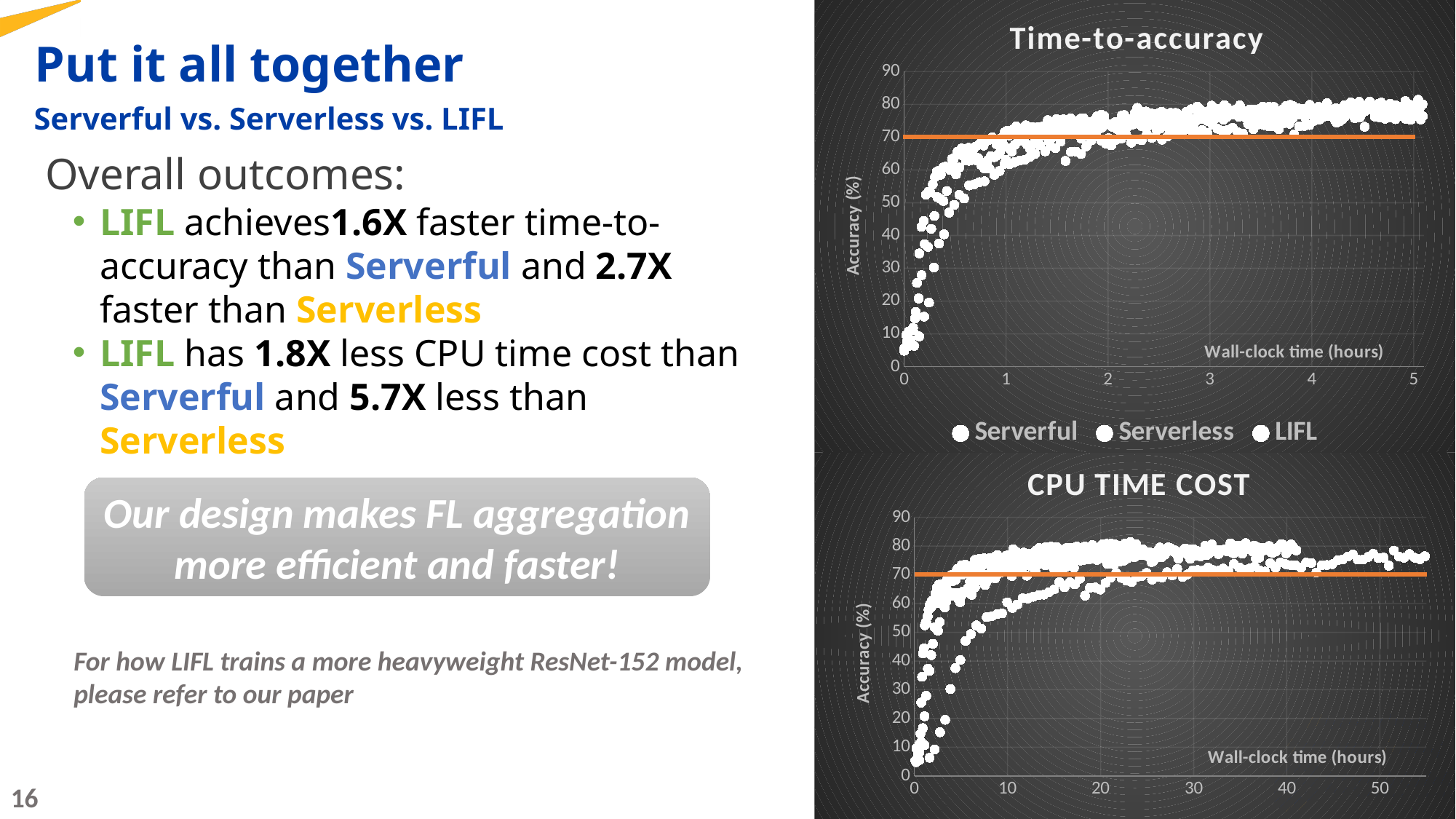
In the "Time-to-accuracy" chart, is the accuracy of the points near 5 hours greater or less than 70? greater What kind of chart is the "CPU TIME COST" chart? scatter chart In the "Time-to-accuracy" chart, do the accuracy values rise or fall as wall-clock time increases? rise What is the highest tick value shown on the x-axis of the "CPU TIME COST" chart? 50 What are the three series named in the legend of the "Time-to-accuracy" chart? Serverful, Serverless, LIFL In the "Time-to-accuracy" chart, is the accuracy of the earliest points near 0 hours greater or less than 20? less How many series does the legend list for the charts on the slide? 3 What is the y-axis label of the "Time-to-accuracy" chart? Accuracy (%) What is the highest tick value shown on the y-axis of the "Time-to-accuracy" chart? 90 In the "CPU TIME COST" chart, do the accuracy values rise or fall as wall-clock time increases? rise In the "CPU TIME COST" chart, is the accuracy of the points near 50 hours greater or less than 60? greater What kind of chart is the "Time-to-accuracy" chart? scatter chart